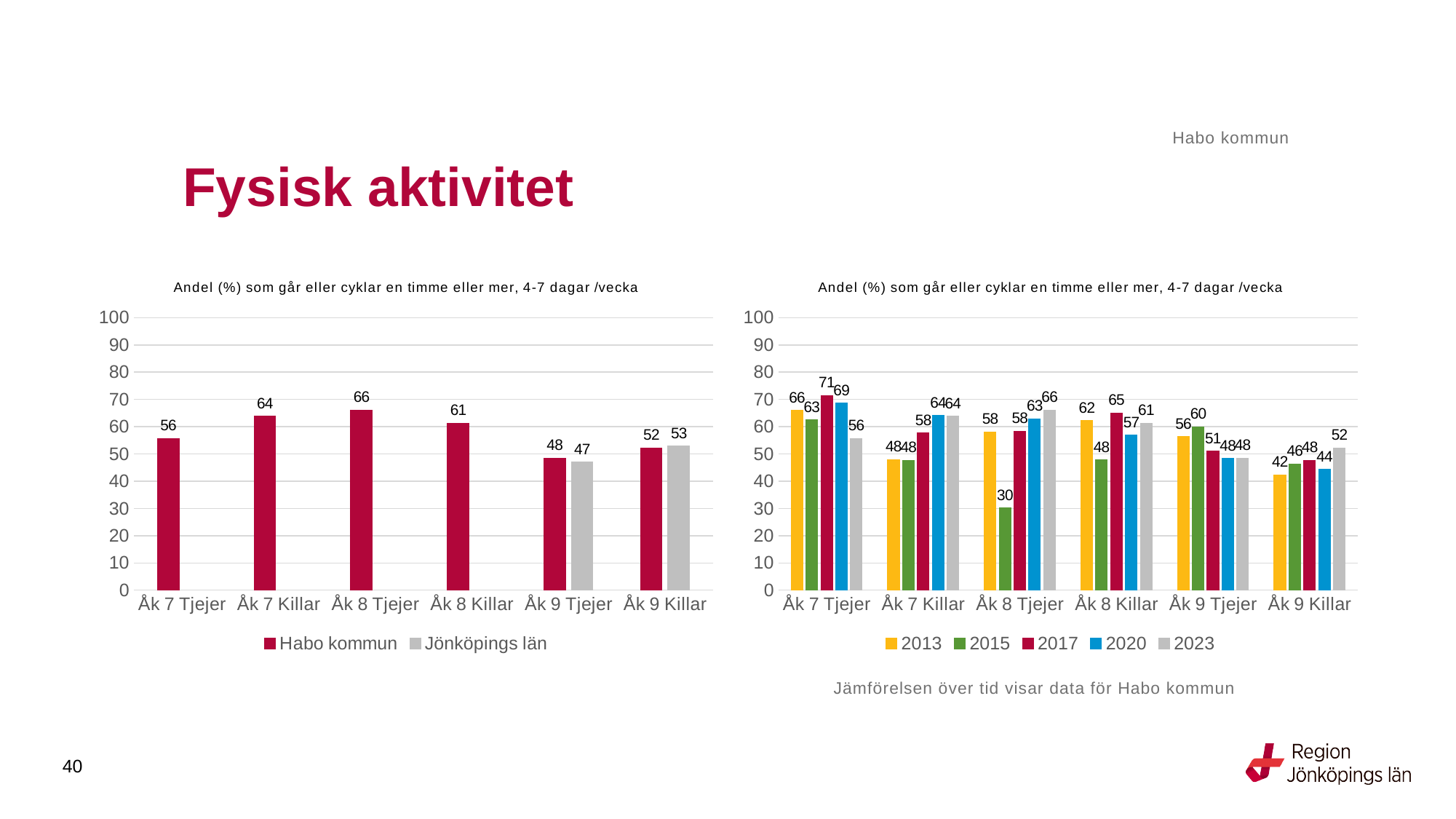
In the left chart, what is the value for Habo kommun for Åk 8 Tjejer? 66 In the right chart, which is larger for Åk 9 Tjejer: 2013 or 2023? 2013 In the right chart, what is the difference between 2013 and 2023 for Åk 9 Killar? 10 What kind of chart is the left chart? Bar chart In the left chart, what is the difference between Habo kommun and Jönköpings län for Åk 9 Killar? 1 In the right chart, what is the value for 2017 for Åk 7 Tjejer? 71 In the left chart, how many series does the legend list? 2 In the right chart, which year has the highest value for Åk 8 Tjejer? 2023 In the left chart, which category has the lowest value for Habo kommun? Åk 9 Tjejer In the right chart, what is the value for 2015 for Åk 8 Tjejer? 30 In the right chart, how many series does the legend list? 5 In the left chart, which category has the highest value for Habo kommun? Åk 8 Tjejer